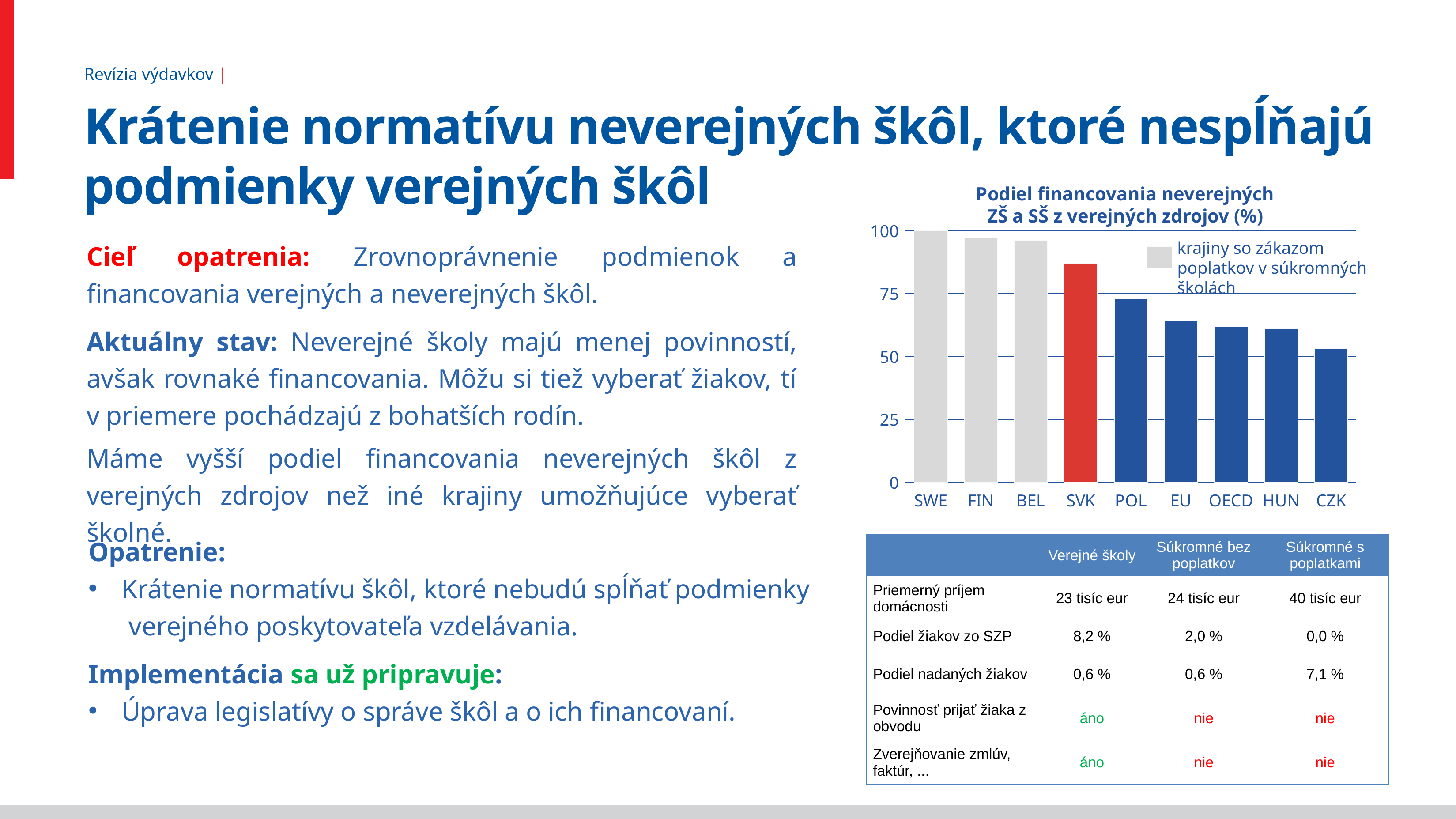
Is the value for EU greater or less than 50? greater What colour is the bar for SVK in the chart? red Is the value for HUN greater or less than 75? less What is the value for SWE in the chart? 100 Which country has the highest share of public funding for non-public schools in the chart? SWE What kind of chart is shown on the slide? bar chart Is the value for SVK greater or less than 75? greater Do the values rise or fall moving from left to right along the x axis? fall Which has a larger value, SVK or POL? SVK Which country has the lowest value in the chart? CZK Which has a larger value, FIN or OECD? FIN How many countries or groups are shown on the x axis of the chart? 9